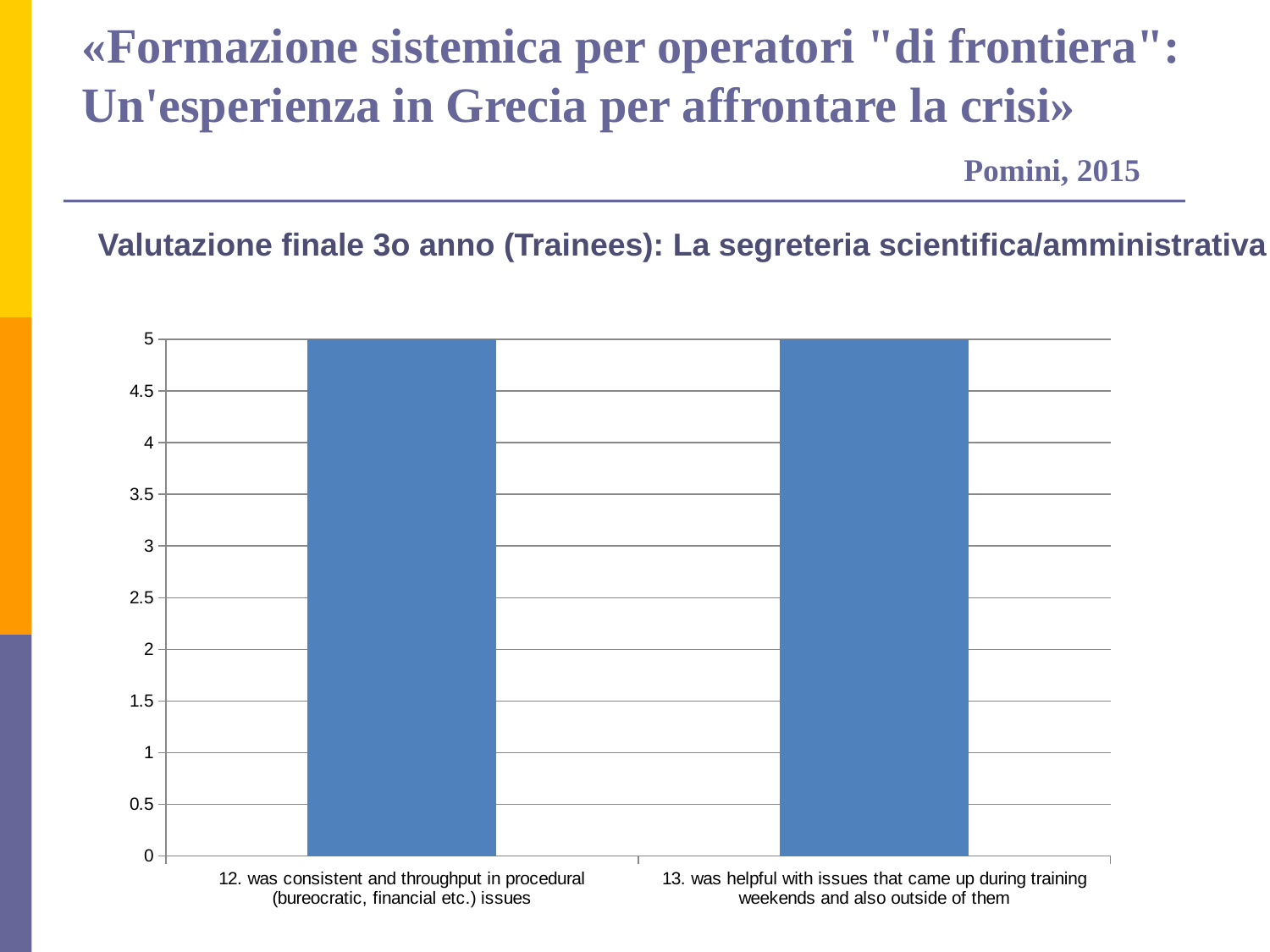
What is the difference between the values for item 12 and item 13? 0 What is the highest value shown on the vertical axis? 5 What kind of chart is shown on the slide? bar chart What is the value for item 13, "was helpful with issues that came up during training weekends and also outside of them"? 5 What is the value for item 12, "was consistent and throughput in procedural (bureocratic, financial etc.) issues"? 5 What is the heading printed above the chart? Valutazione finale 3o anno (Trainees): La segreteria scientifica/amministrativa Do the values rise, fall or stay the same from item 12 to item 13? stay the same How many categories (bars) does the chart show? 2 Is the value for item 13 greater or less than 3? greater Is the value for item 12 greater or less than 4? greater